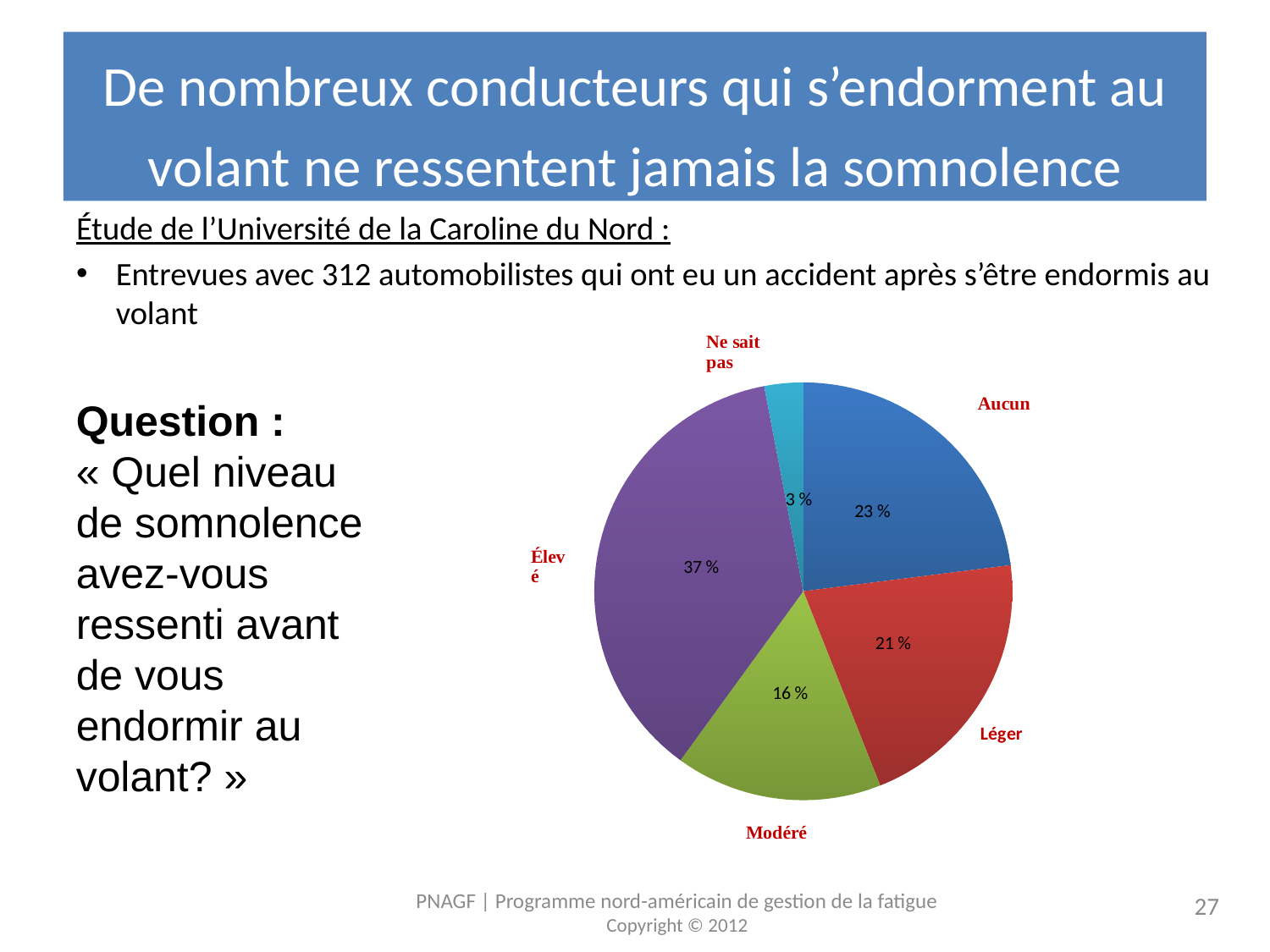
What colour is the "Élevé" slice of the pie? purple Which slice of the pie is the largest? Élevé What share of the pie is labelled "Ne sait pas"? 3 % Which slice of the pie is the smallest? Ne sait pas What share of the pie is labelled "Modéré"? 16 % Which slice is larger, "Aucun" or "Modéré"? Aucun What share of the pie is labelled "Aucun"? 23 % What share of the pie is labelled "Élevé"? 37 % What is the difference in percentage points between the "Élevé" slice and the "Aucun" slice? 14 How many slices does the pie chart have? 5 What share of the pie is labelled "Léger"? 21 % What kind of chart is shown on the slide? pie chart